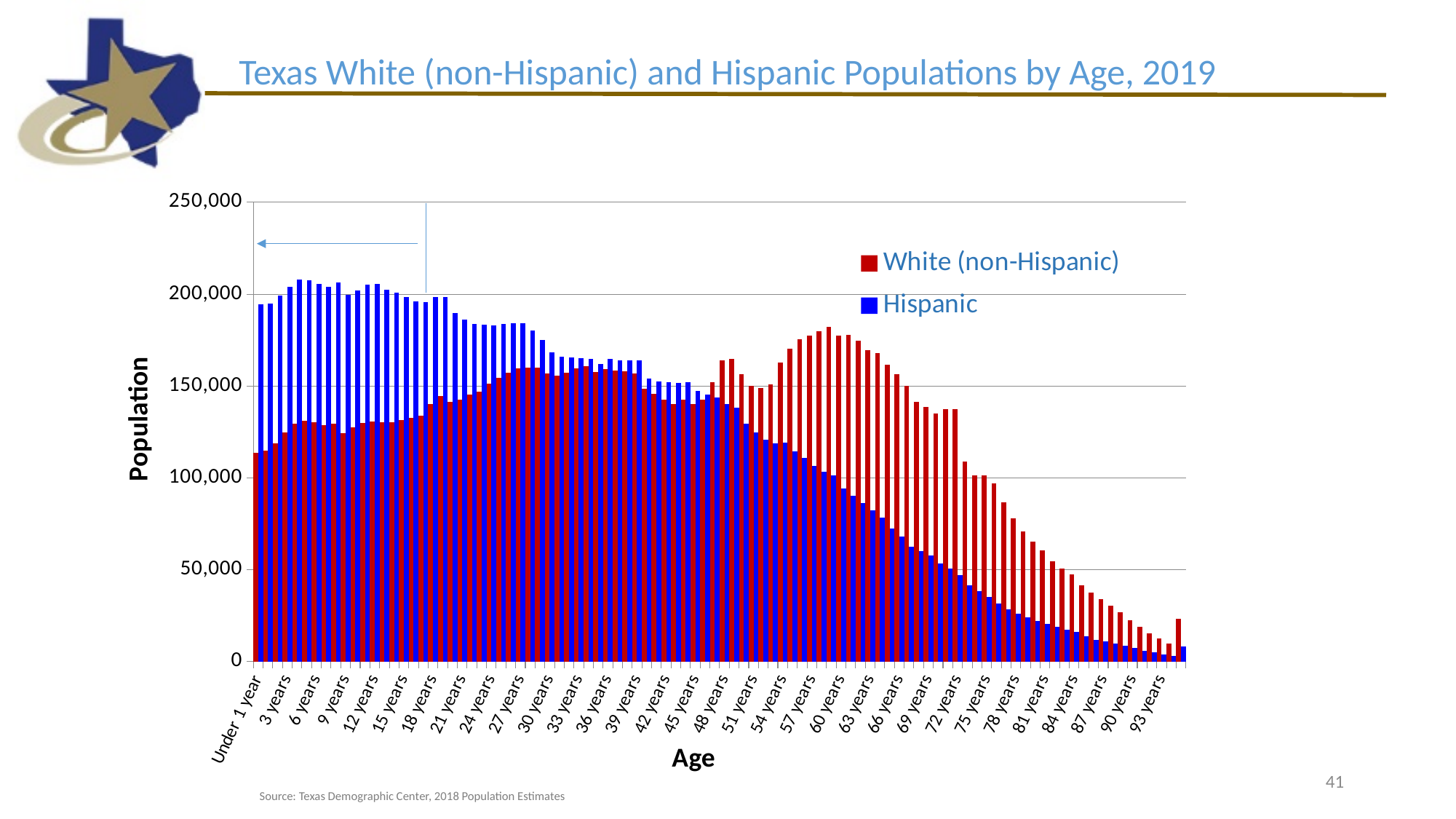
At Under 1 year, which series has the larger value, White (non-Hispanic) or Hispanic? Hispanic What kind of chart is shown on the slide? bar chart Do the Hispanic values generally rise or fall as age increases along the x axis? fall How many series does the legend list? 2 Is the Hispanic value for 6 years greater or less than 200,000? greater What is the title of the chart? Texas White (non-Hispanic) and Hispanic Populations by Age, 2019 Which colour represents the Hispanic series? blue Is the Hispanic value for 90 years greater or less than 50,000? less At 60 years, which series has the larger value, White (non-Hispanic) or Hispanic? White (non-Hispanic) Is the White (non-Hispanic) value for Under 1 year greater or less than 150,000? less